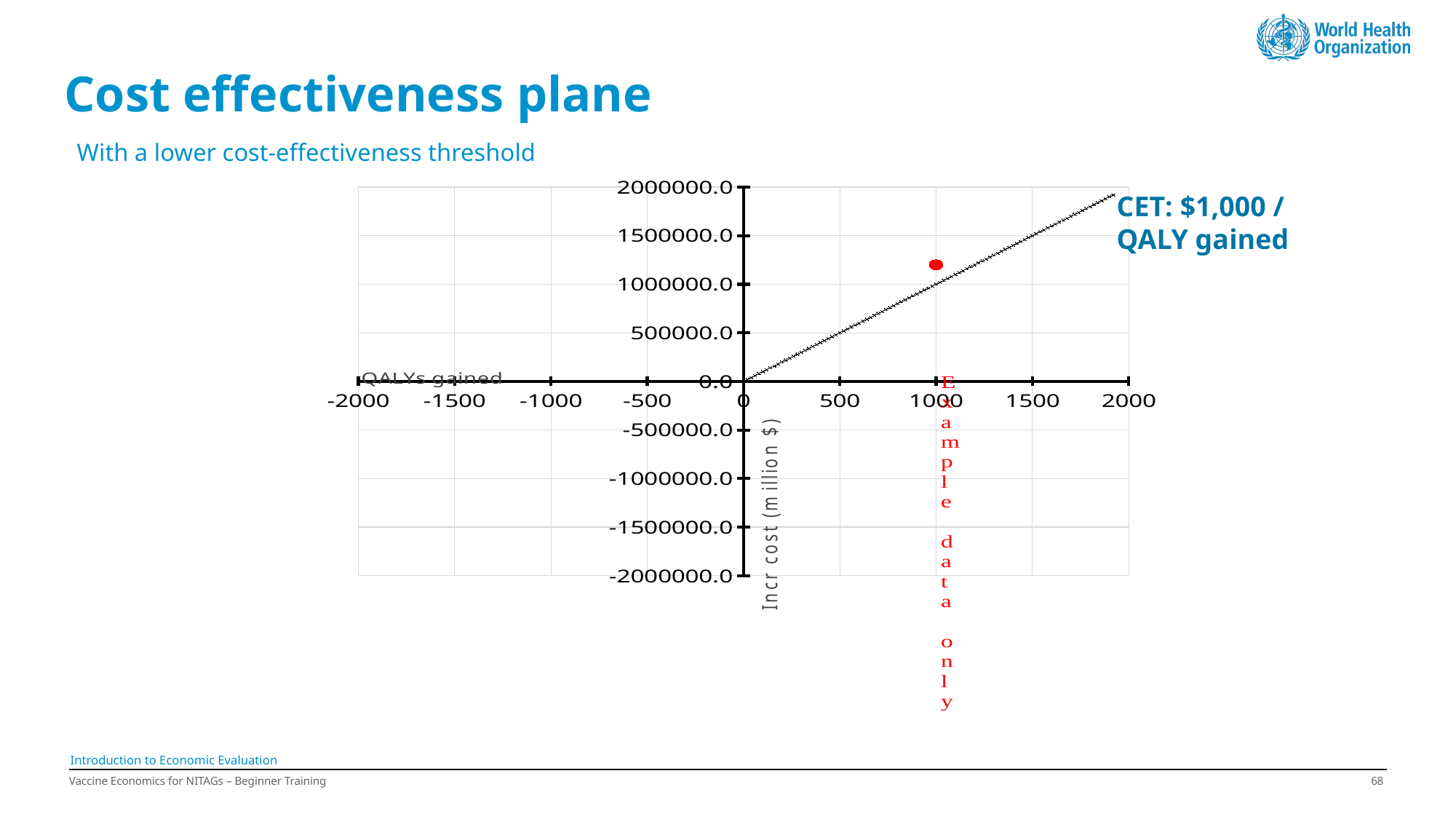
Does the dotted threshold line rise or fall as QALYs gained increases? rises What kind of chart is shown on the slide? scatter chart Does the red data point lie above or below the dotted cost-effectiveness threshold line? above Is the QALYs gained value of the red data point greater or less than 1500? less Is the incremental cost value of the red data point greater or less than 1000000.0? greater Is the incremental cost value of the red data point greater or less than 1500000.0? less What is the label of the vertical axis? Incr cost (million $) How many red data points are plotted on the cost effectiveness plane? 1 What is the minimum value shown on the vertical axis? -2000000.0 What is the label of the horizontal axis? QALYs gained What is the maximum value shown on the horizontal axis? 2000